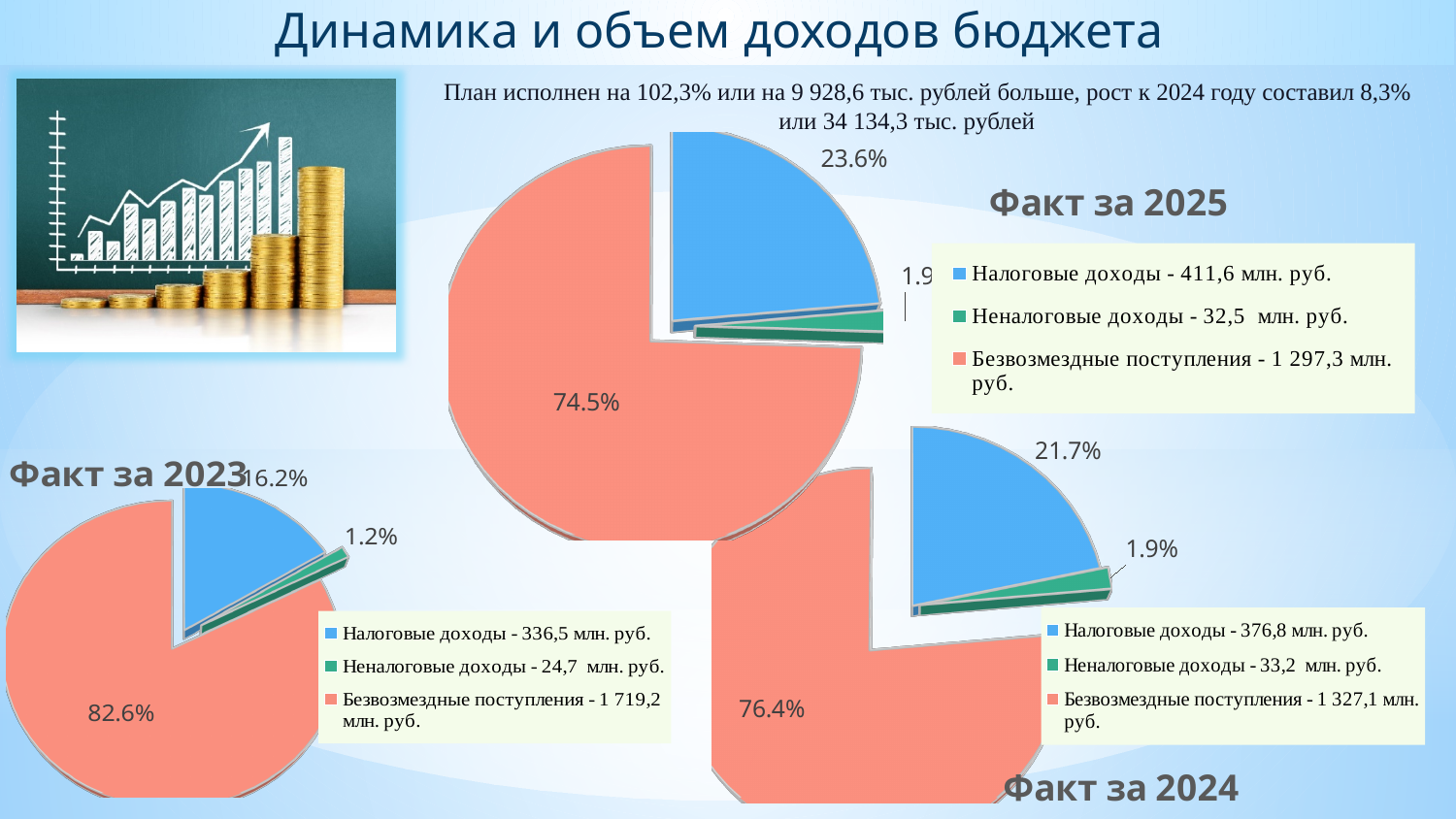
In the 'Факт за 2025' chart legend, what value is given for Неналоговые доходы? 32,5 млн. руб. What type of chart is the 'Факт за 2024' chart? Pie chart In the 'Факт за 2023' chart legend, what value is given for Налоговые доходы? 336,5 млн. руб. In the 'Факт за 2023' pie chart, what share is labelled for the Безвозмездные поступления slice? 82.6% In the 'Факт за 2023' pie chart, what share is labelled for the Неналоговые доходы slice? 1.2% In the 'Факт за 2025' pie chart, what share is labelled for the Налоговые доходы slice? 23.6% In the 'Факт за 2025' chart legend, what value is given for Безвозмездные поступления? 1 297,3 млн. руб. In the 'Факт за 2024' chart legend, what value is given for Безвозмездные поступления? 1 327,1 млн. руб. In the 'Факт за 2023' pie chart, which category has the smallest slice? Неналоговые доходы In the 'Факт за 2024' pie chart, which category has the largest slice? Безвозмездные поступления